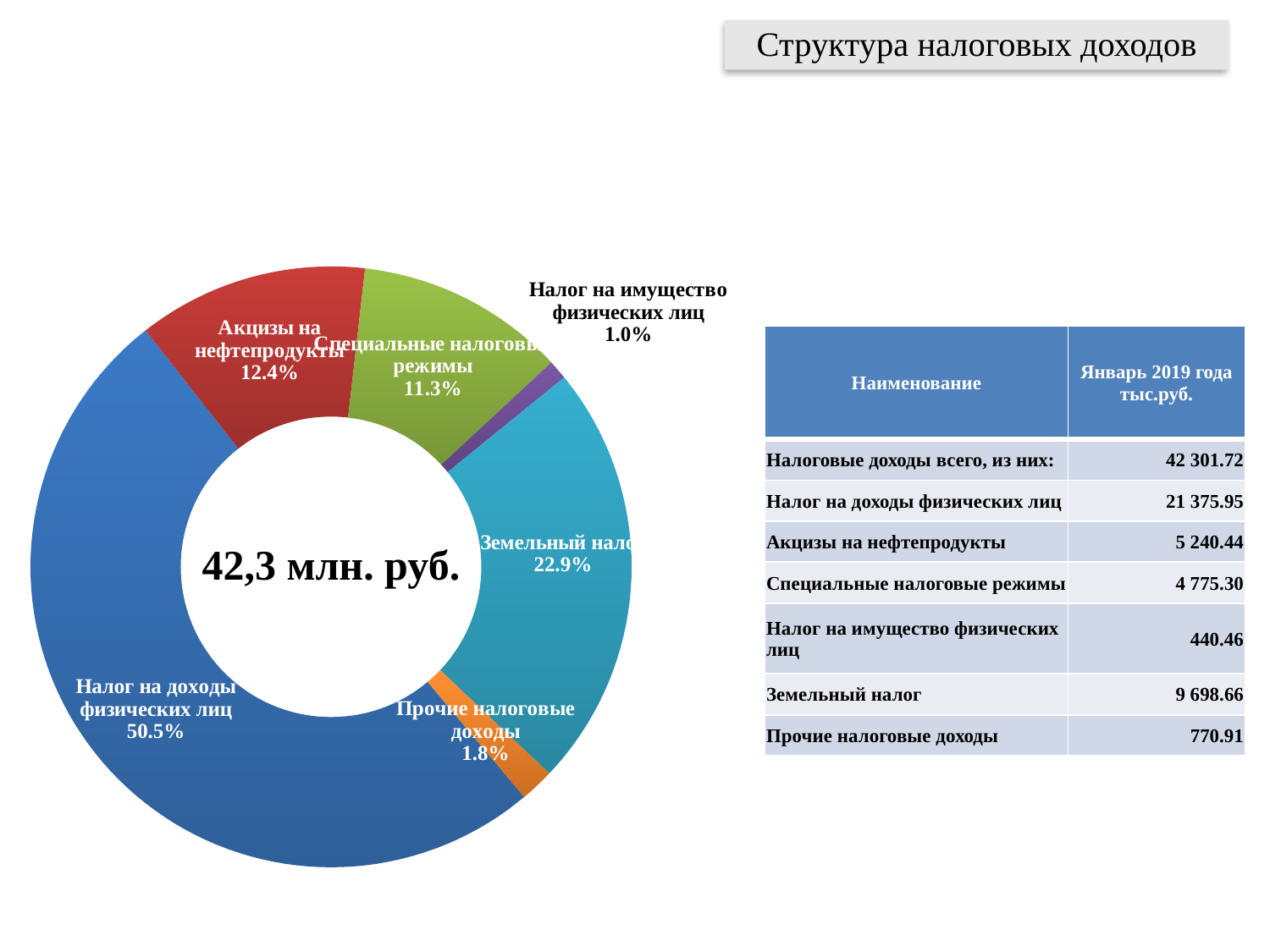
By how many percentage points does the share of "Налог на доходы физических лиц" exceed that of "Земельный налог"? 27.6 percentage points Which category has the smallest share in the chart? Налог на имущество физических лиц What total value is printed in the centre of the doughnut chart? 42,3 млн. руб. What kind of chart is shown on the slide? Doughnut (pie) chart Which has the larger share in the chart: "Акцизы на нефтепродукты" or "Специальные налоговые режимы"? Акцизы на нефтепродукты What share of tax revenues does "Налог на доходы физических лиц" account for in the chart? 50.5% Which category has the largest share in the chart? Налог на доходы физических лиц What percentage is shown for "Прочие налоговые доходы" in the chart? 1.8% How many categories (slices) does the chart contain? 6 What percentage is shown for "Земельный налог" in the chart? 22.9% What percentage is shown for "Специальные налоговые режимы" in the chart? 11.3% What percentage is shown for "Акцизы на нефтепродукты" in the chart? 12.4%